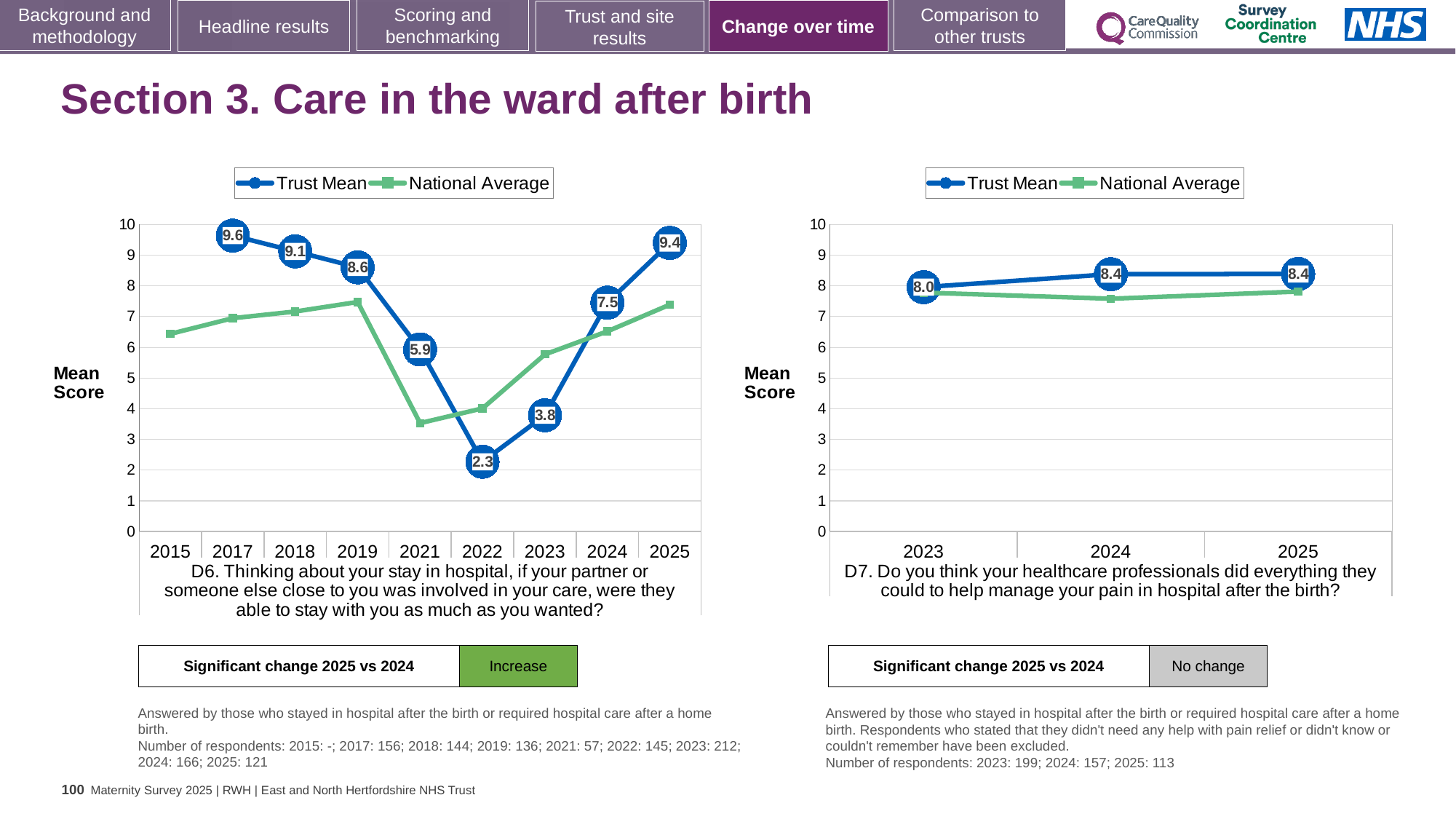
In the D6 chart on the left, what is the Trust Mean score for 2025? 9.4 In the D6 chart on the left, what is the difference between the Trust Mean scores for 2025 and 2024? 1.9 In the D6 chart on the left, which year has the lowest Trust Mean score? 2022 In the D7 chart on the right, what is the Trust Mean score for 2023? 8.0 In the D6 chart on the left, is the Trust Mean score for 2019 greater or less than 8? greater In the D6 chart on the left, what is the Trust Mean score for 2022? 2.3 In the D6 chart on the left, is the National Average for 2022 greater or less than 5? less In the D7 chart on the right, how many years are shown on the x axis? 3 In the D7 chart on the right, how many series does the legend list? 2 In the D6 chart on the left, which year has the highest Trust Mean score? 2017 In the D7 chart on the right, which is larger, the Trust Mean for 2023 or for 2024? 2024 What type of chart is the D6 chart on the left? Line chart